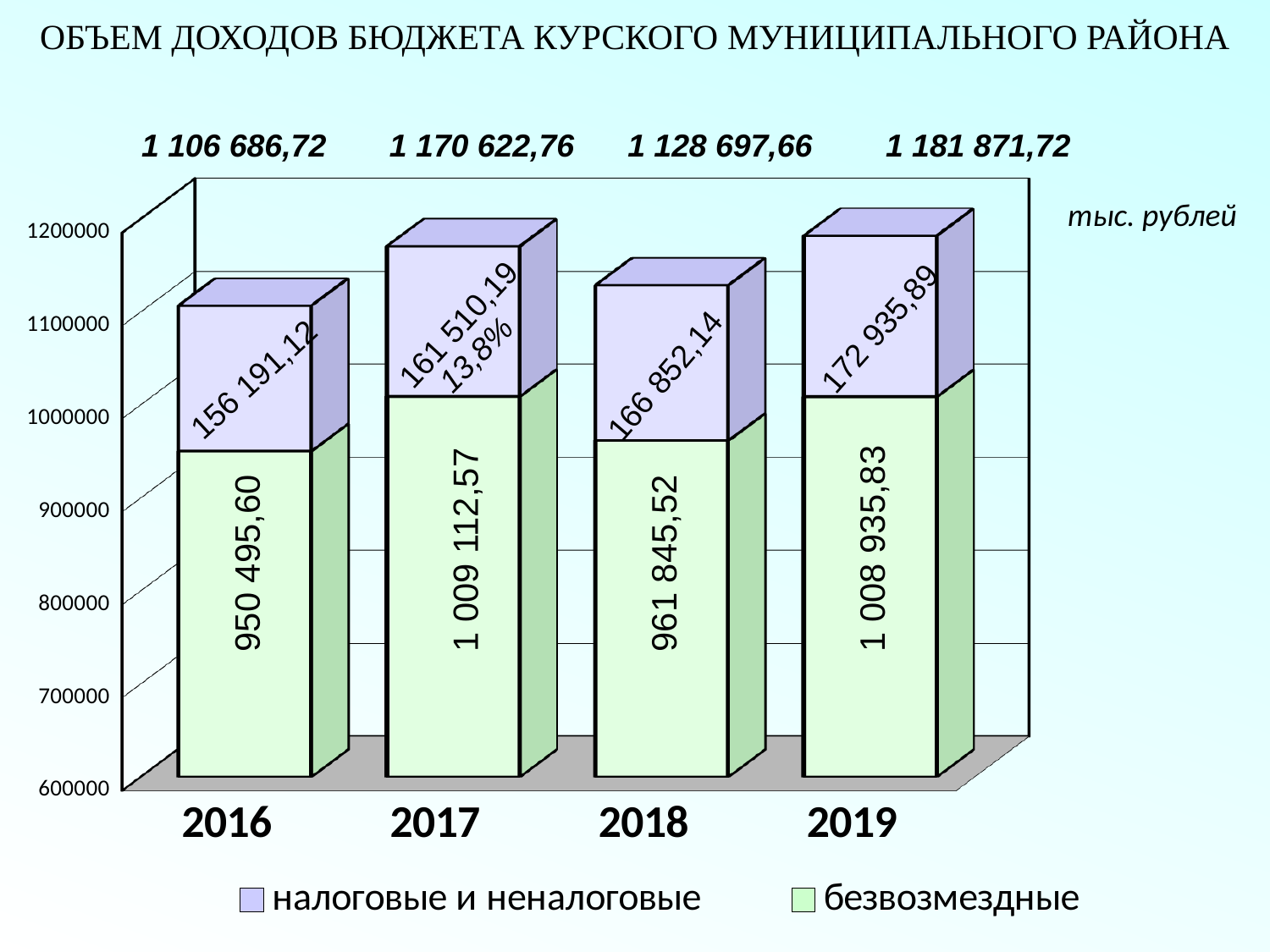
What is the value of безвозмездные for 2018? 961 845,52 Which year has the highest value for налоговые и неналоговые? 2019 What is the total shown above the bar for 2017? 1 170 622,76 What is the difference between налоговые и неналоговые in 2019 and in 2016? 16 744,77 Which is larger, безвозмездные in 2017 or безвозмездные in 2019? 2017 What unit is indicated next to the chart? тыс. рублей Which year has the lowest total budget income? 2016 How many series does the legend list? 2 What is the value of безвозмездные for 2016? 950 495,60 How many years are shown on the x axis? 4 What is the value of налоговые и неналоговые for 2019? 172 935,89 What type of chart is shown on the slide? stacked bar chart